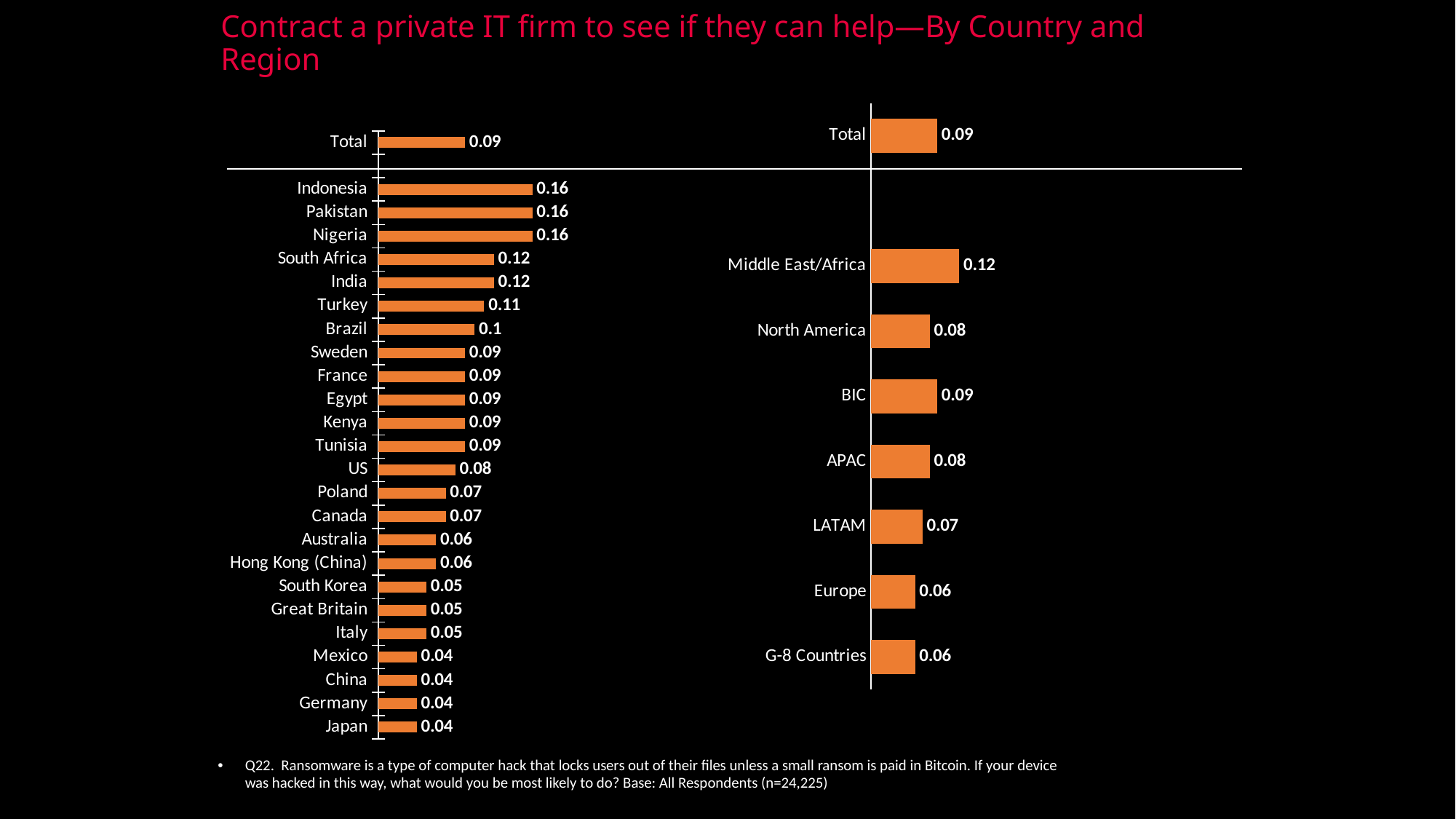
How many countries (excluding Total) are listed in the left chart? 24 In the right chart (by region), which is larger, the value for BIC or the value for G-8 Countries? BIC In the right chart (by region), which region has the highest value? Middle East/Africa In the left chart (by country), what is the value for Turkey? 0.11 In the right chart (by region), what is the difference between the values for Middle East/Africa and Europe? 0.06 In the left chart (by country), what is the value for Brazil? 0.1 What kind of chart is the right chart (by region)? Bar chart In the left chart (by country), what is the value for Hong Kong (China)? 0.06 In the right chart (by region), what is the value for LATAM? 0.07 In the left chart (by country), which is larger, the value for South Africa or the value for US? South Africa How many regions (excluding Total) are listed in the right chart? 7 In the left chart (by country), what is the difference between the values for Indonesia and Japan? 0.12